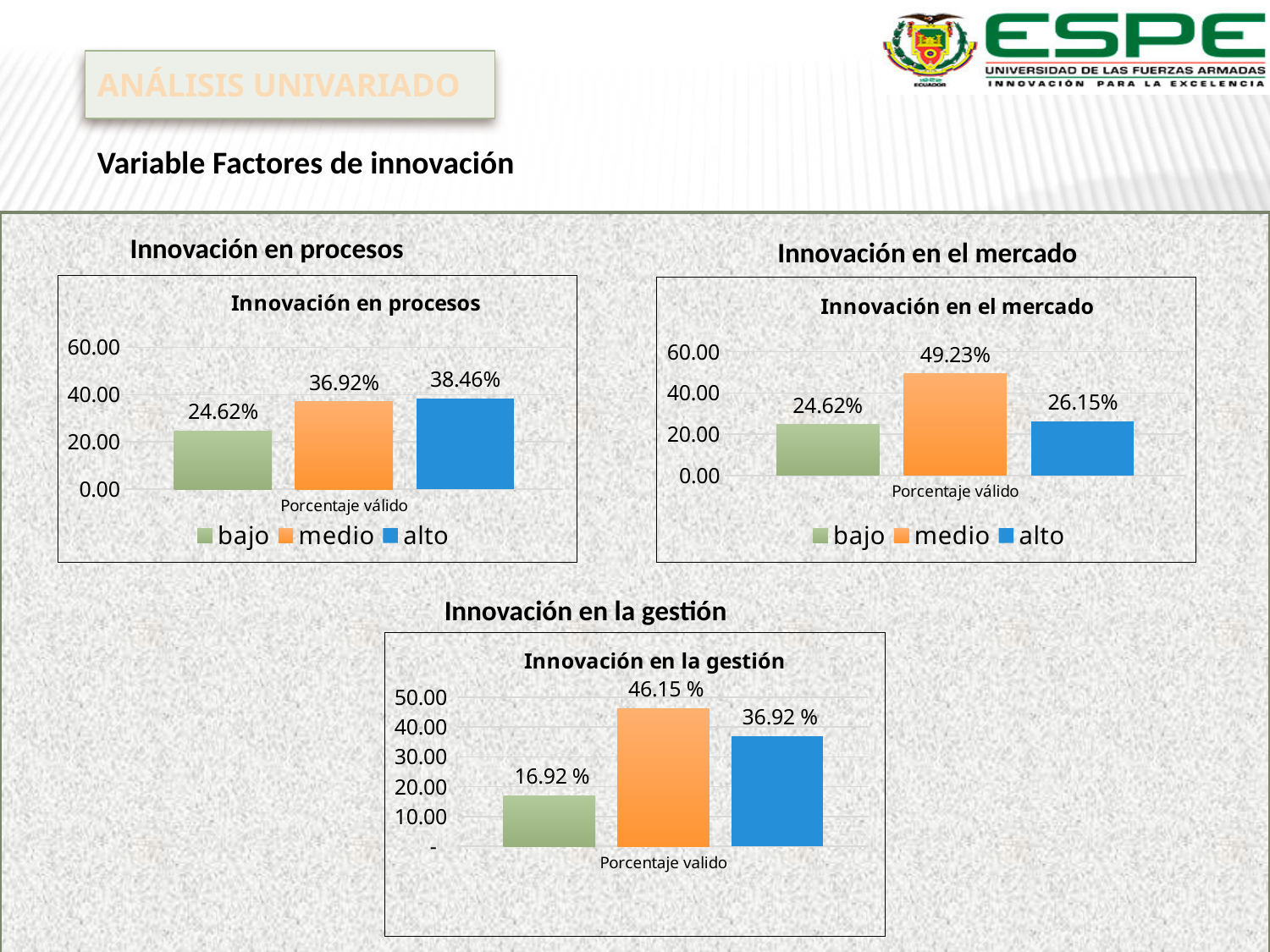
In the 'Innovación en la gestión' chart, what is the value shown on the orange bar? 46.15 % How many series does the legend of the 'Innovación en procesos' chart list? 3 In the 'Innovación en la gestión' chart, what is the value shown on the green bar? 16.92 % In the 'Innovación en el mercado' chart, what is the value for 'medio'? 49.23% In the 'Innovación en la gestión' chart, what is the difference between the orange bar and the green bar? 29.23 % What kind of chart is 'Innovación en el mercado'? bar chart In the 'Innovación en procesos' chart, what is the value for 'medio'? 36.92% In the 'Innovación en el mercado' chart, what is the difference between the values for 'medio' and 'bajo'? 24.61% In the 'Innovación en el mercado' chart, is the value for 'alto' larger or smaller than the value for 'medio'? smaller In the 'Innovación en procesos' chart, what is the difference between the values for 'alto' and 'medio'? 1.54% In the 'Innovación en el mercado' chart, which category has the lowest value? bajo In the 'Innovación en procesos' chart, which category has the highest value? alto